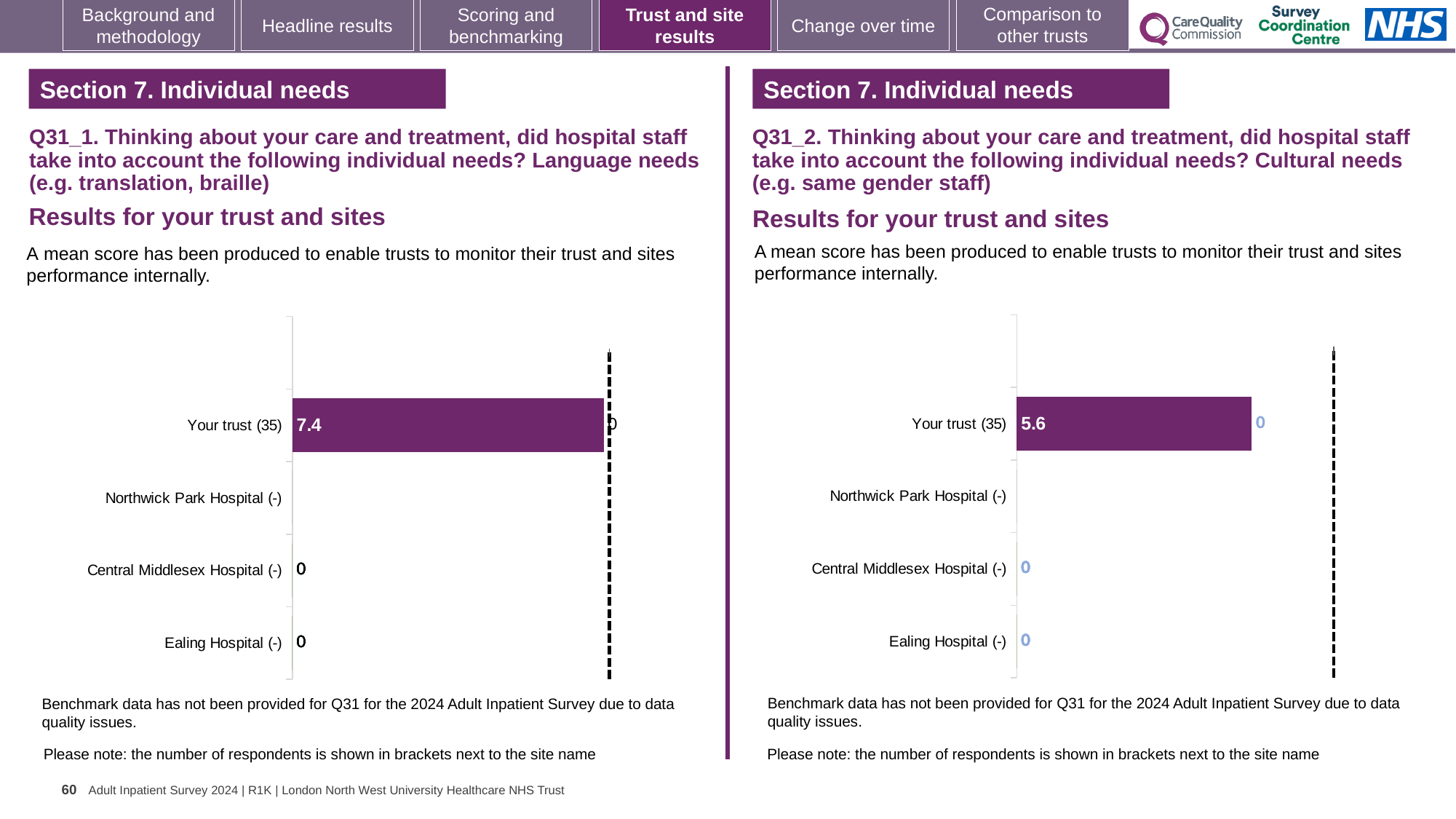
In the Q31_2 chart on the right (Cultural needs), what is the mean score for Your trust (35)? 5.6 How many site/trust categories are listed on the y axis of the Q31_2 chart on the right? 4 What is the difference between the Your trust score in the left chart (Q31_1) and the Your trust score in the right chart (Q31_2)? 1.8 Which is larger: the Your trust score in the Q31_1 chart on the left or the Your trust score in the Q31_2 chart on the right? Q31_1 (left), 7.4 How many site/trust categories are listed on the y axis of the Q31_1 chart on the left? 4 Which individual need does the question for the chart on the right (Q31_2) refer to? Cultural needs (e.g. same gender staff) In the Q31_1 chart on the left (Language needs), what is the mean score for Your trust (35)? 7.4 In the Q31_1 chart on the left, which category has the highest mean score? Your trust (35) How many respondents are shown in brackets next to Your trust in the Q31_2 chart on the right? 35 In the Q31_2 chart on the right, which category has the highest mean score? Your trust (35) What type of chart is used in the Q31_1 chart on the left? Bar chart Which individual need does the question for the chart on the left (Q31_1) refer to? Language needs (e.g. translation, braille)